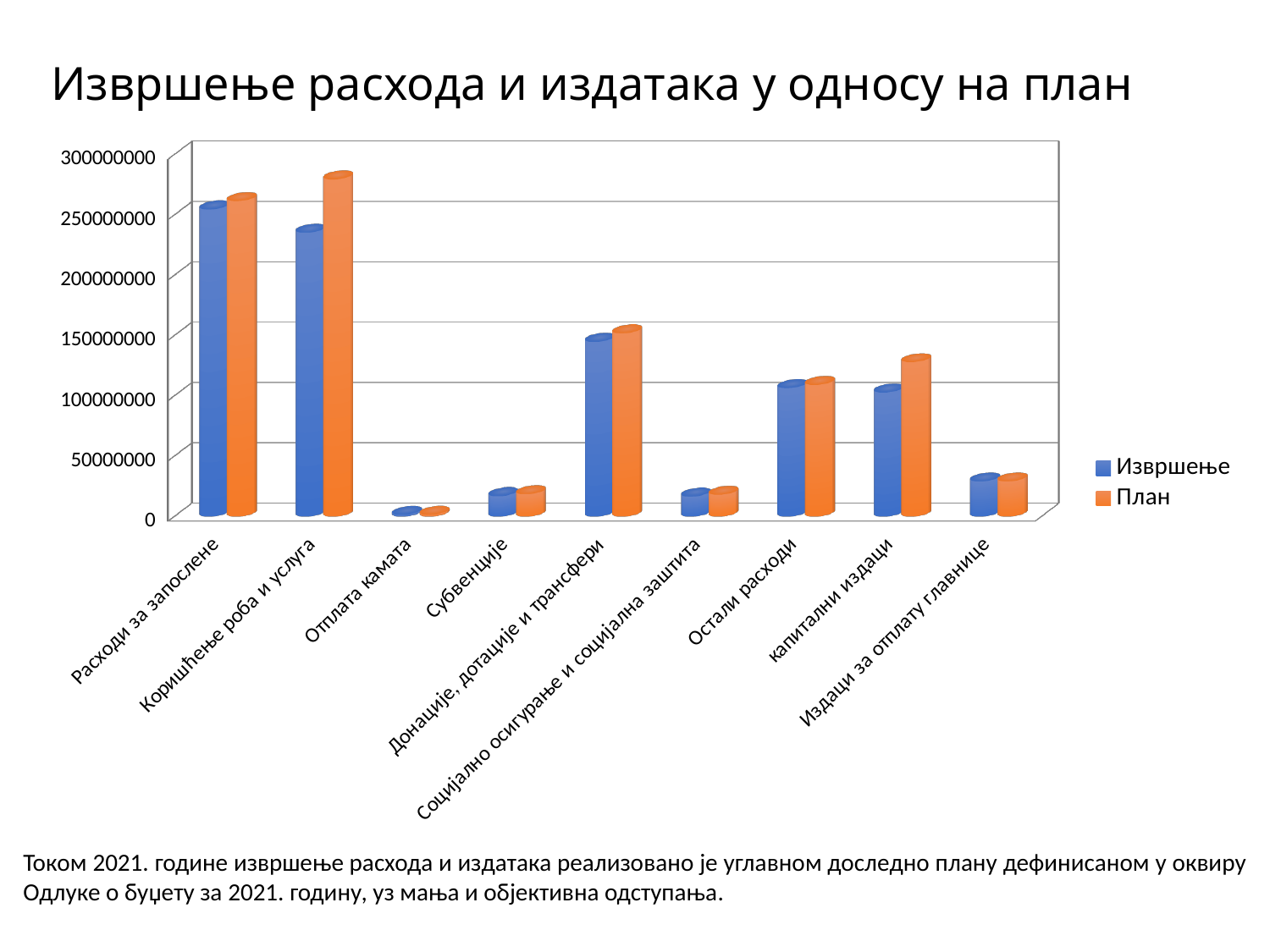
Which category has the highest Извршење value? Расходи за запослене What kind of chart is shown on the slide? bar chart Is the Извршење value for Коришћење роба и услуга greater or less than 250000000? less What is the title of the chart? Извршење расхода и издатака у односу на план Is the План value for Коришћење роба и услуга greater or less than 250000000? greater How many series does the legend list? 2 Is the План value for капитални издаци greater or less than 100000000? greater Which category has the highest План value? Коришћење роба и услуга Which category has the lowest Извршење value? Отплата камата For капитални издаци, which is larger: Извршење or План? План How many categories are shown on the x axis? 9 For Коришћење роба и услуга, which is larger: Извршење or План? План